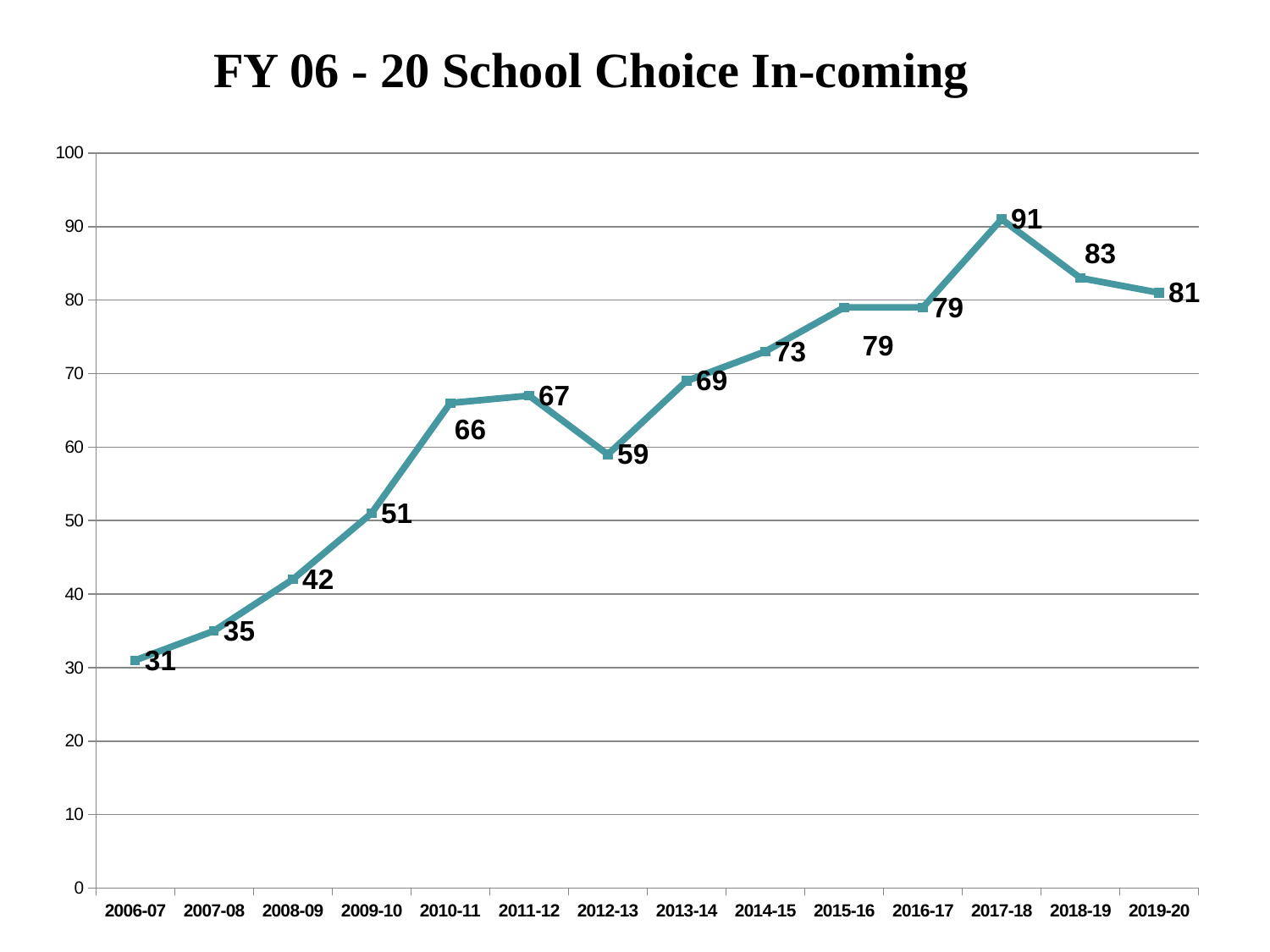
Do the values rise or fall from 2017-18 to 2019-20? Fall What is the value for 2006-07? 31 Which year has the highest value? 2017-18 What is the difference between the values for 2017-18 and 2019-20? 10 Which year has the lowest value? 2006-07 What is the value for 2010-11? 66 What kind of chart is shown on the slide? Line chart What is the value for 2017-18? 91 Which is larger, the value for 2018-19 or the value for 2016-17? 2018-19 What is the title of the chart? FY 06 - 20 School Choice In-coming How many data points are plotted on the chart? 14 What is the difference between the values for 2012-13 and 2011-12? 8